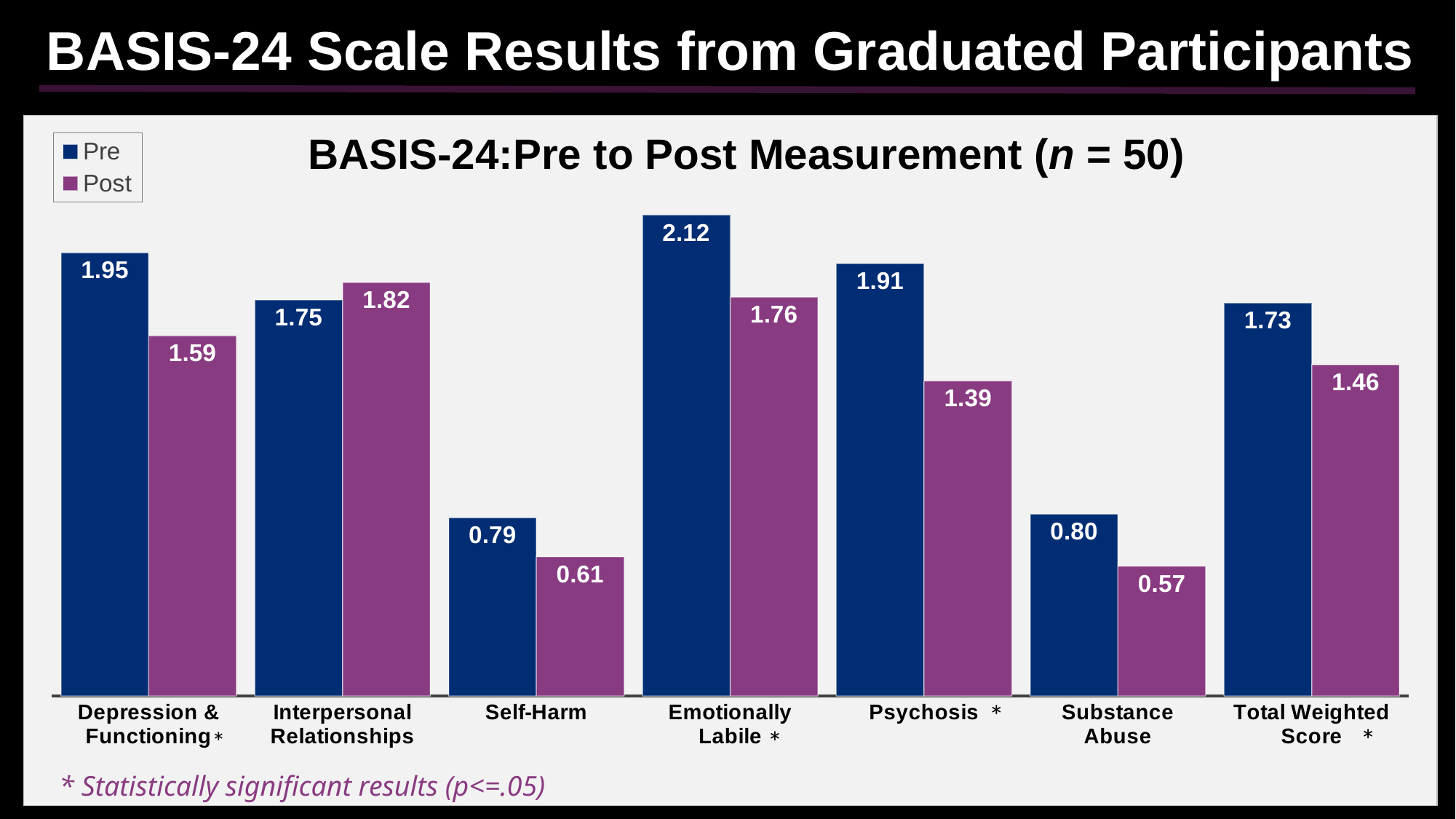
How many series does the legend list? 2 How many categories are shown on the x axis? 7 Which colour represents the Post series in the legend? Purple Which category has the lowest Post value? Substance Abuse Which category has the highest Pre value? Emotionally Labile What kind of chart is shown on the slide? Bar chart What is the Post value for Total Weighted Score? 1.46 What is the difference between the Pre and Post values for Psychosis? 0.52 What is the Post value for Substance Abuse? 0.57 What is the title of the chart? BASIS-24:Pre to Post Measurement (n = 50) What is the Pre value for Emotionally Labile? 2.12 Which is larger for Interpersonal Relationships, the Pre value or the Post value? Post